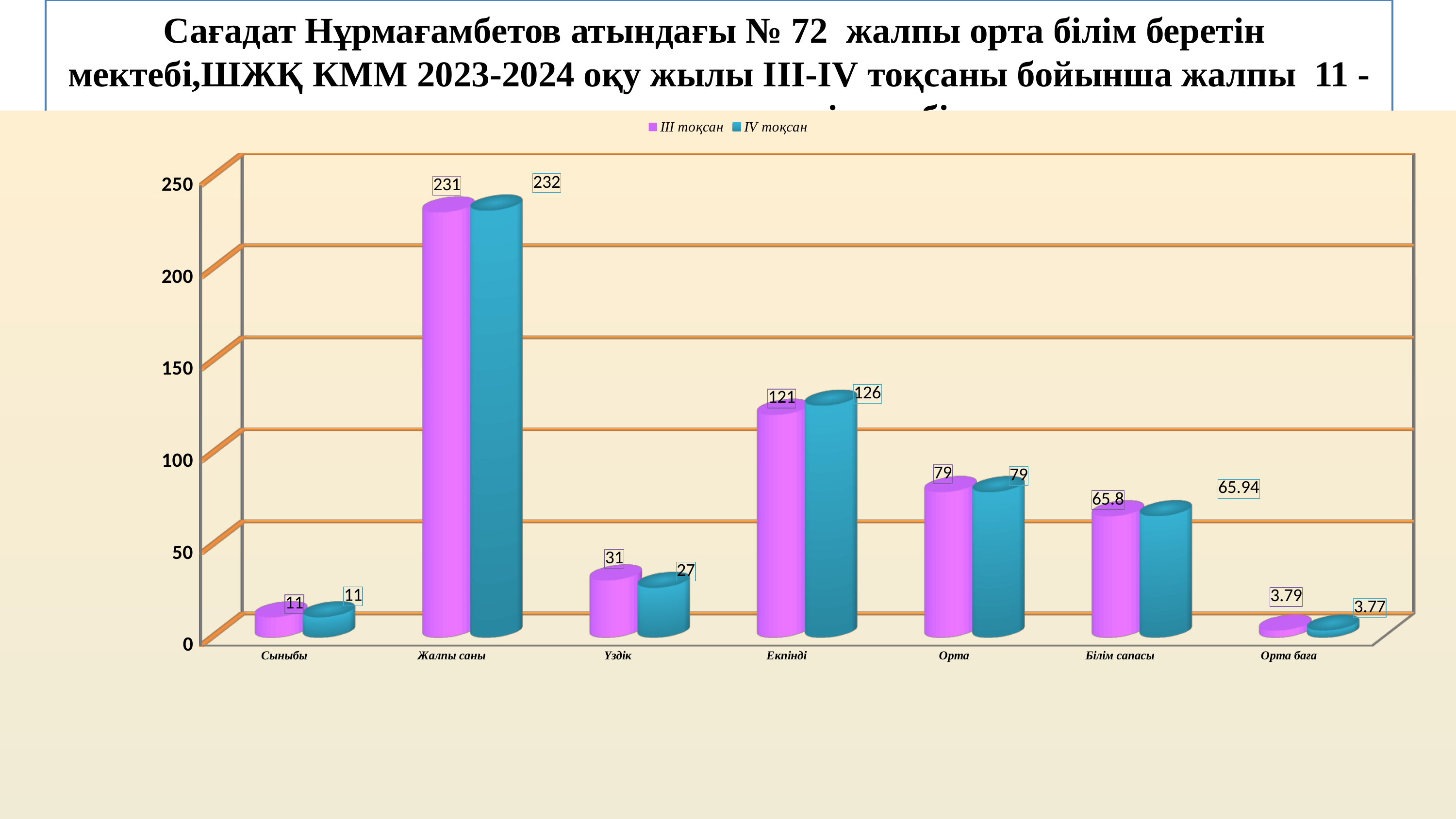
Which category has the lowest value in the III тоқсан series? Орта баға What is the value for Жалпы саны in the III тоқсан series? 231 What is the value for Орта баға in the III тоқсан series? 3.79 How many categories are shown on the x axis? 7 For Үздік, which series has the larger value, III тоқсан or IV тоқсан? III тоқсан How many series does the legend list? 2 What colour are the bars for the IV тоқсан series? Teal What is the value for Білім сапасы in the IV тоқсан series? 65.94 What is the difference between the IV тоқсан and III тоқсан values for Екпінді? 5 Which category has the highest value in the IV тоқсан series? Жалпы саны What kind of chart is shown on the slide? Bar chart What is the value for Екпінді in the IV тоқсан series? 126